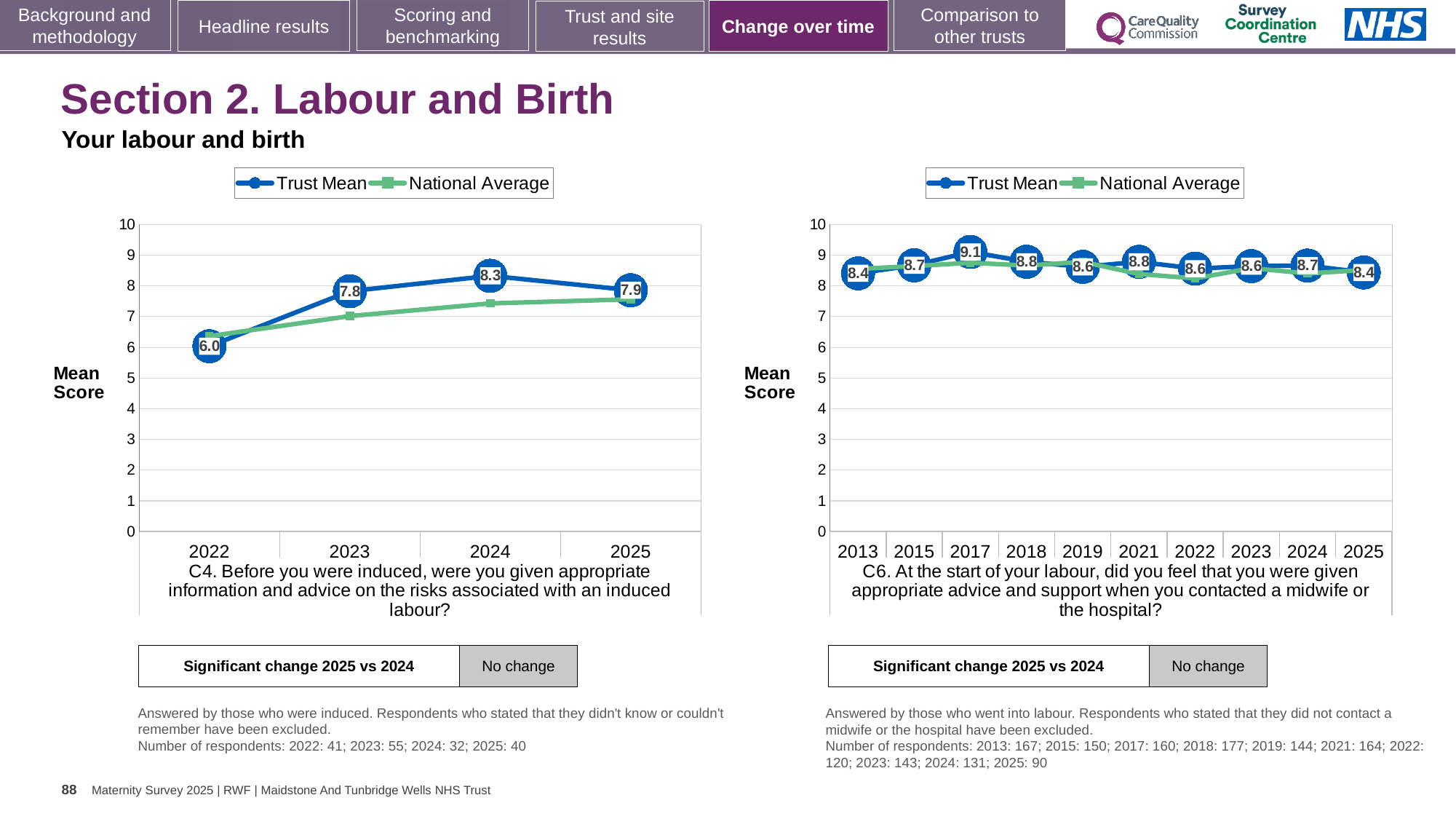
In the right chart (C6), which year has the highest Trust Mean? 2017 What kind of chart is the right chart (C6)? Line chart In the left chart (C4), what is the difference between the Trust Mean in 2024 and in 2022? 2.3 In the right chart (C6), how many series does the legend list? 2 In the right chart (C6), what is the Trust Mean for 2017? 9.1 In the left chart (C4), what is the Trust Mean for 2024? 8.3 In the left chart (C4), how many years are shown on the x axis? 4 In the left chart (C4), what is the Trust Mean for 2022? 6.0 In the right chart (C6), what is the Trust Mean for 2025? 8.4 In the left chart (C4), which year has the highest Trust Mean? 2024 In the left chart (C4), is the National Average for 2023 greater or less than 8? less In the right chart (C6), which is larger, the Trust Mean for 2018 or for 2019? 2018